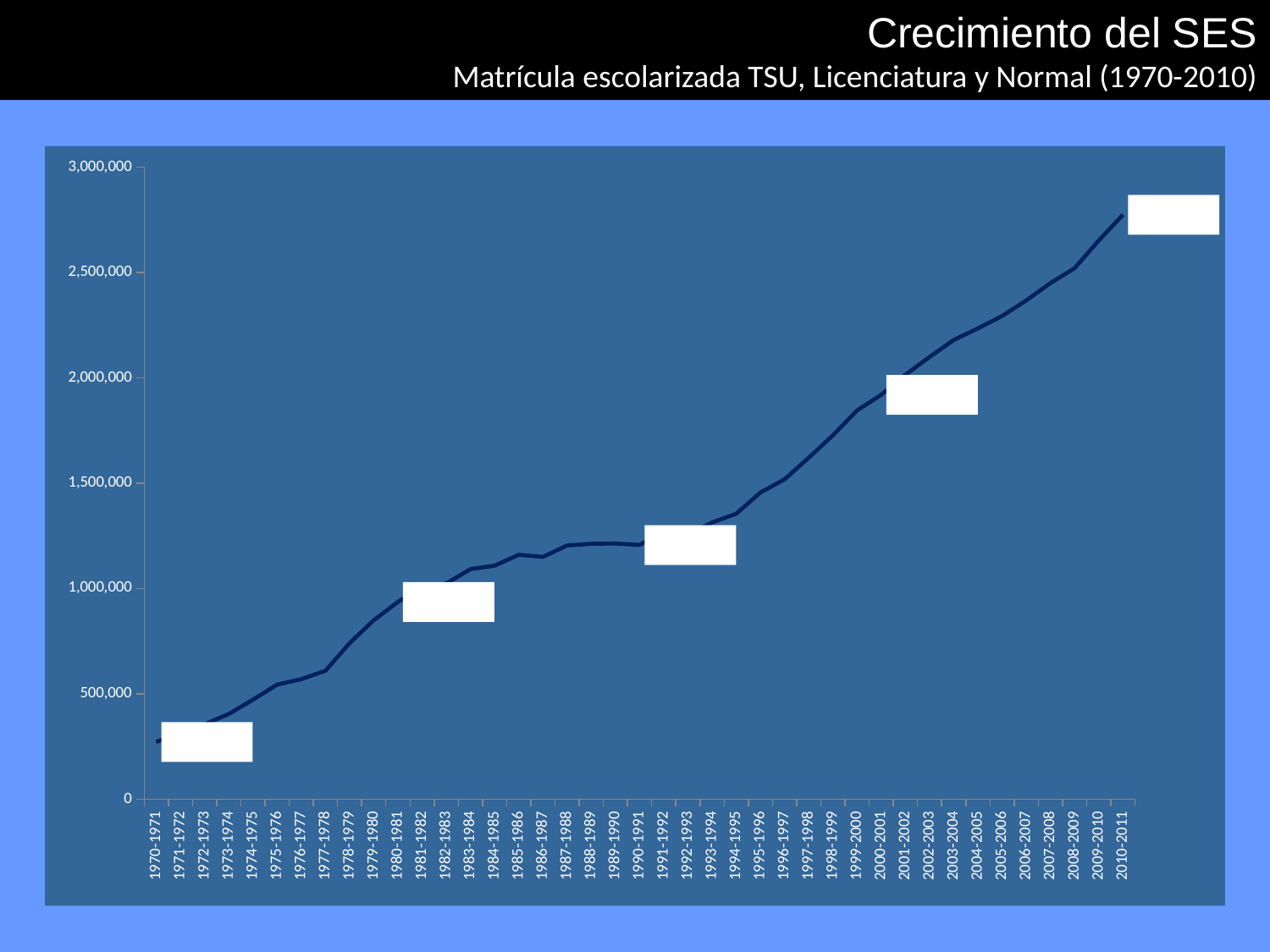
Is the value for 2010-2011 greater or less than 2,500,000? greater Is the value for 1970-1971 greater or less than 500,000? less What kind of chart is shown on the slide? line chart Which academic year has the lowest value on the chart? 1970-1971 Is the value for 1977-1978 greater or less than 1,000,000? less Which academic year has the highest value on the chart? 2010-2011 Which is larger, the value for 2000-2001 or the value for 1990-1991? 2000-2001 What is the subtitle of the chart shown on the slide? Matrícula escolarizada TSU, Licenciatura y Normal (1970-2010) How many academic years are plotted along the x axis? 41 Does the enrollment value generally rise or fall from 1970-1971 to 2010-2011? rise